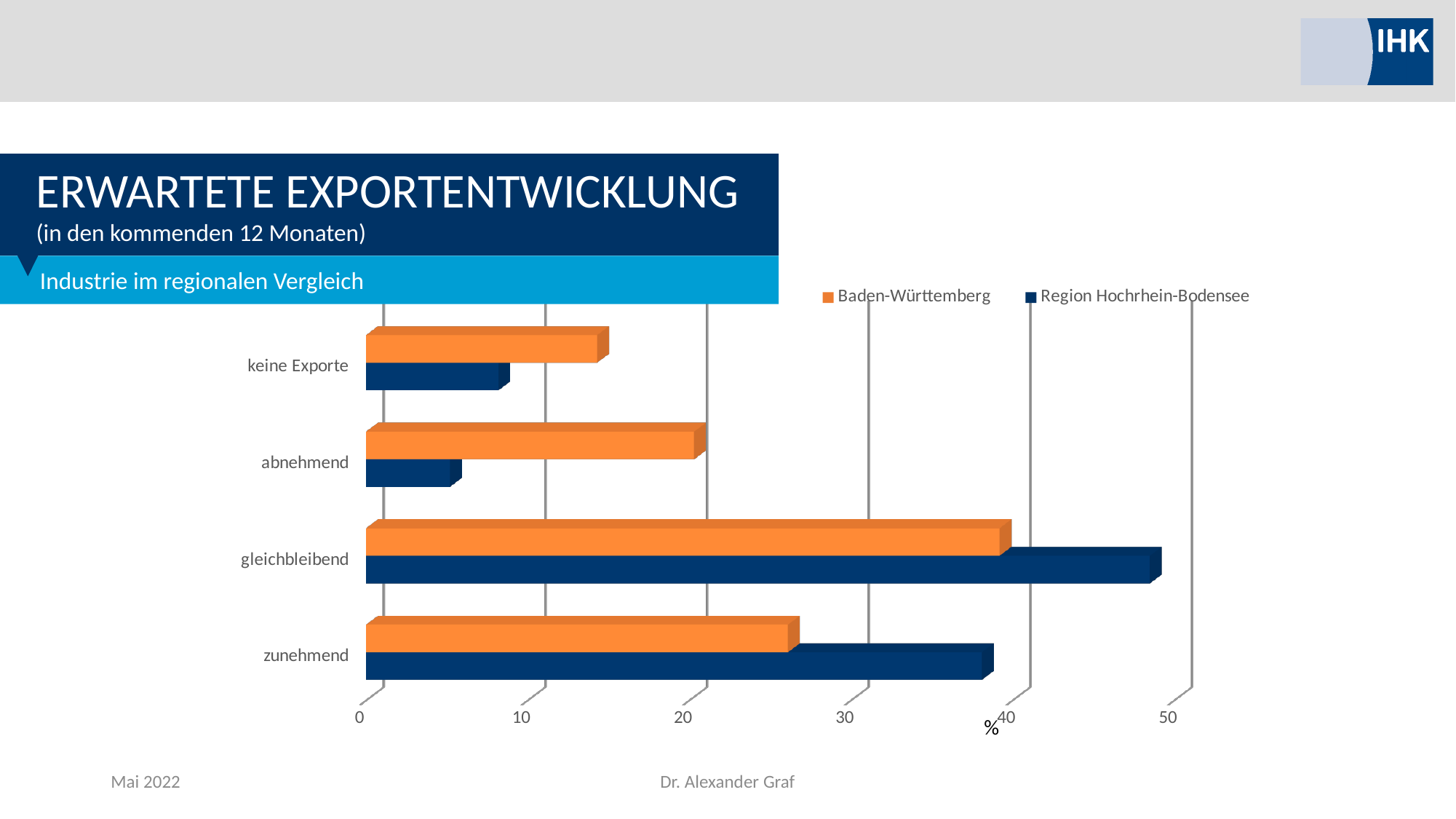
What kind of chart is shown on the slide? bar chart Which colour represents Baden-Württemberg in the chart? orange For the category gleichbleibend, which series has the larger value: Baden-Württemberg or Region Hochrhein-Bodensee? Region Hochrhein-Bodensee How many categories are shown on the vertical axis of the chart? 4 Which category has the lowest value for Baden-Württemberg? keine Exporte Which category has the highest value for Region Hochrhein-Bodensee? gleichbleibend Is the value for Baden-Württemberg in the category gleichbleibend greater or less than 30? greater Which category has the lowest value for Region Hochrhein-Bodensee? abnehmend Is the value for Region Hochrhein-Bodensee in the category abnehmend greater or less than 10? less Is the value for Region Hochrhein-Bodensee in the category zunehmend greater or less than 30? greater How many series does the legend list? 2 For the category keine Exporte, which series has the larger value: Baden-Württemberg or Region Hochrhein-Bodensee? Baden-Württemberg